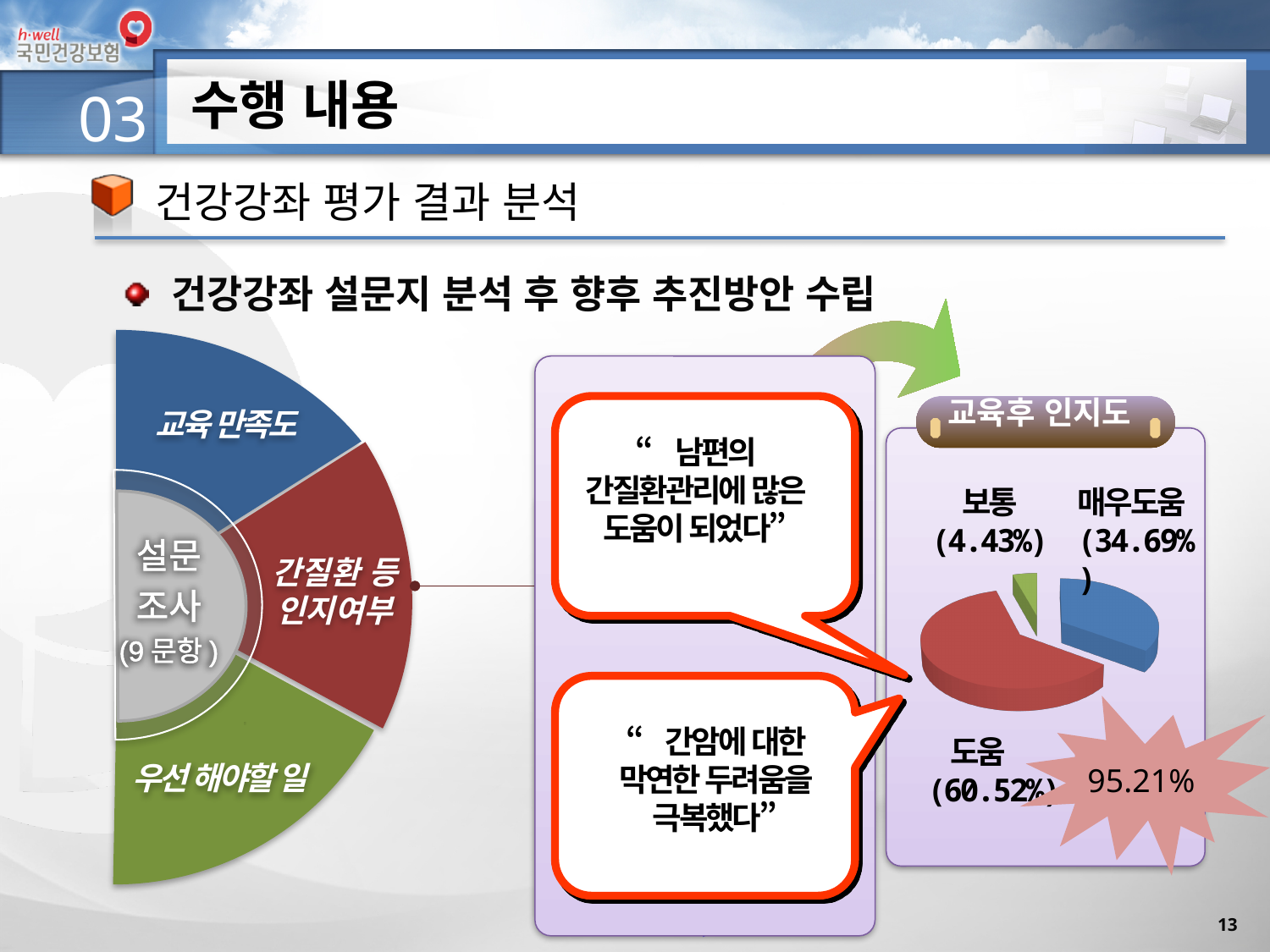
In the 교육후 인지도 pie chart, which category has the smallest share? 보통 What kind of chart is shown under the heading 교육후 인지도? pie chart In the 교육후 인지도 pie chart, which is larger, 매우도움 or 보통? 매우도움 What is the title shown above the pie chart? 교육후 인지도 In the 교육후 인지도 pie chart, what is the combined share of 도움 and 매우도움? 95.21% In the 교육후 인지도 pie chart, what is the difference between 도움 and 매우도움? 25.83% In the 교육후 인지도 pie chart, what is the value for 매우도움? 34.69% In the 교육후 인지도 pie chart, how many slices are there? 3 In the 교육후 인지도 pie chart, what is the value for 도움? 60.52% In the 교육후 인지도 pie chart, which category has the largest share? 도움 In the 교육후 인지도 pie chart, what is the value for 보통? 4.43% In the 교육후 인지도 pie chart, what colour is the 도움 slice? red